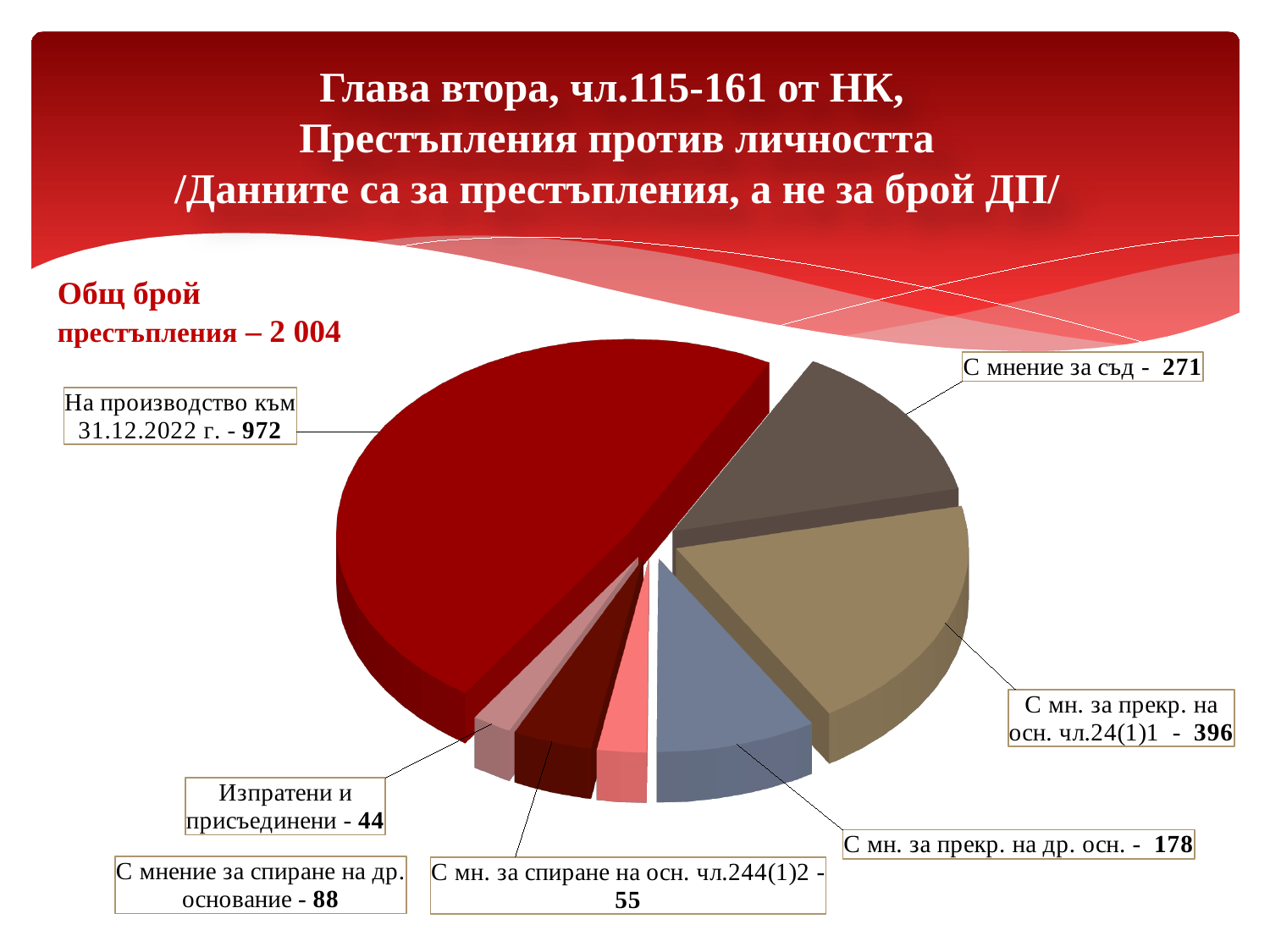
How many slices does the pie chart have? 7 What is the value for "На производство към 31.12.2022 г."? 972 What is the difference between "С мн. за прекр. на осн. чл.24(1)1" and "С мн. за прекр. на др. осн."? 218 Which category has the smallest slice of the pie? Изпратени и присъединени Which is larger: "С мнение за спиране на др. основание" or "С мн. за спиране на осн. чл.244(1)2"? С мнение за спиране на др. основание What is the value for "С мнение за съд"? 271 What kind of chart is shown on the slide? Pie chart What is the total number of crimes stated on the slide (Общ брой престъпления)? 2 004 Which category has the largest slice of the pie? На производство към 31.12.2022 г. What is the difference between "На производство към 31.12.2022 г." and "С мнение за съд"? 701 What is the value for "С мн. за прекр. на осн. чл.24(1)1"? 396 What is the value for "Изпратени и присъединени"? 44